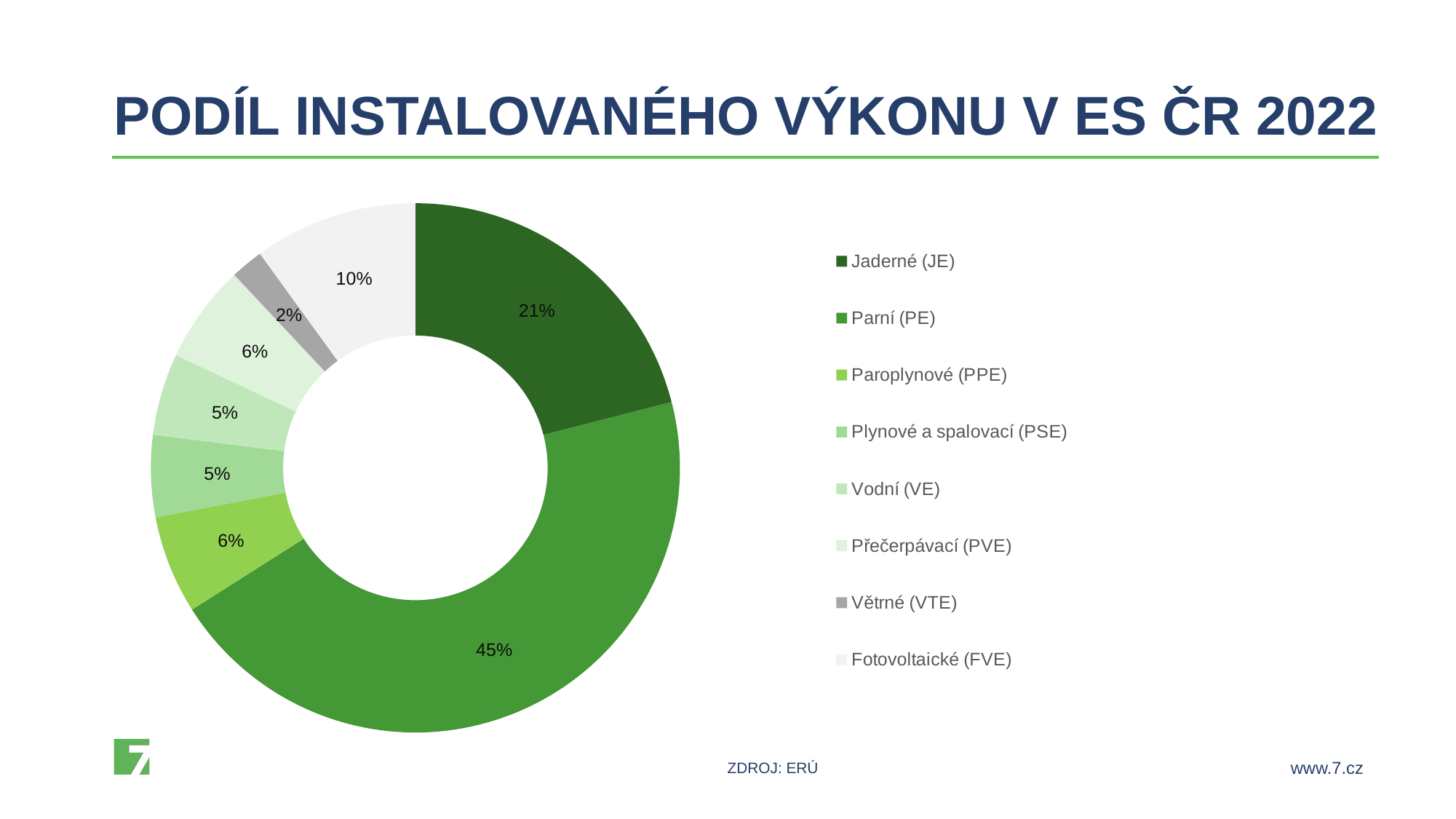
What share is shown for Jaderné (JE)? 21% What is the difference in percentage points between Parní (PE) and Jaderné (JE)? 24 What type of chart is shown on the slide? doughnut chart Which has a larger share, Fotovoltaické (FVE) or Paroplynové (PPE)? Fotovoltaické (FVE) Which category has the largest share of the chart? Parní (PE) What share is shown for Větrné (VTE)? 2% What percentage is shown for Fotovoltaické (FVE)? 10% How many categories are shown in the chart? 8 Which category has the smallest share of the chart? Větrné (VTE) What share of installed capacity does Parní (PE) hold? 45% What source is cited at the bottom of the slide? ERÚ What is the title of the chart on the slide? PODÍL INSTALOVANÉHO VÝKONU V ES ČR 2022